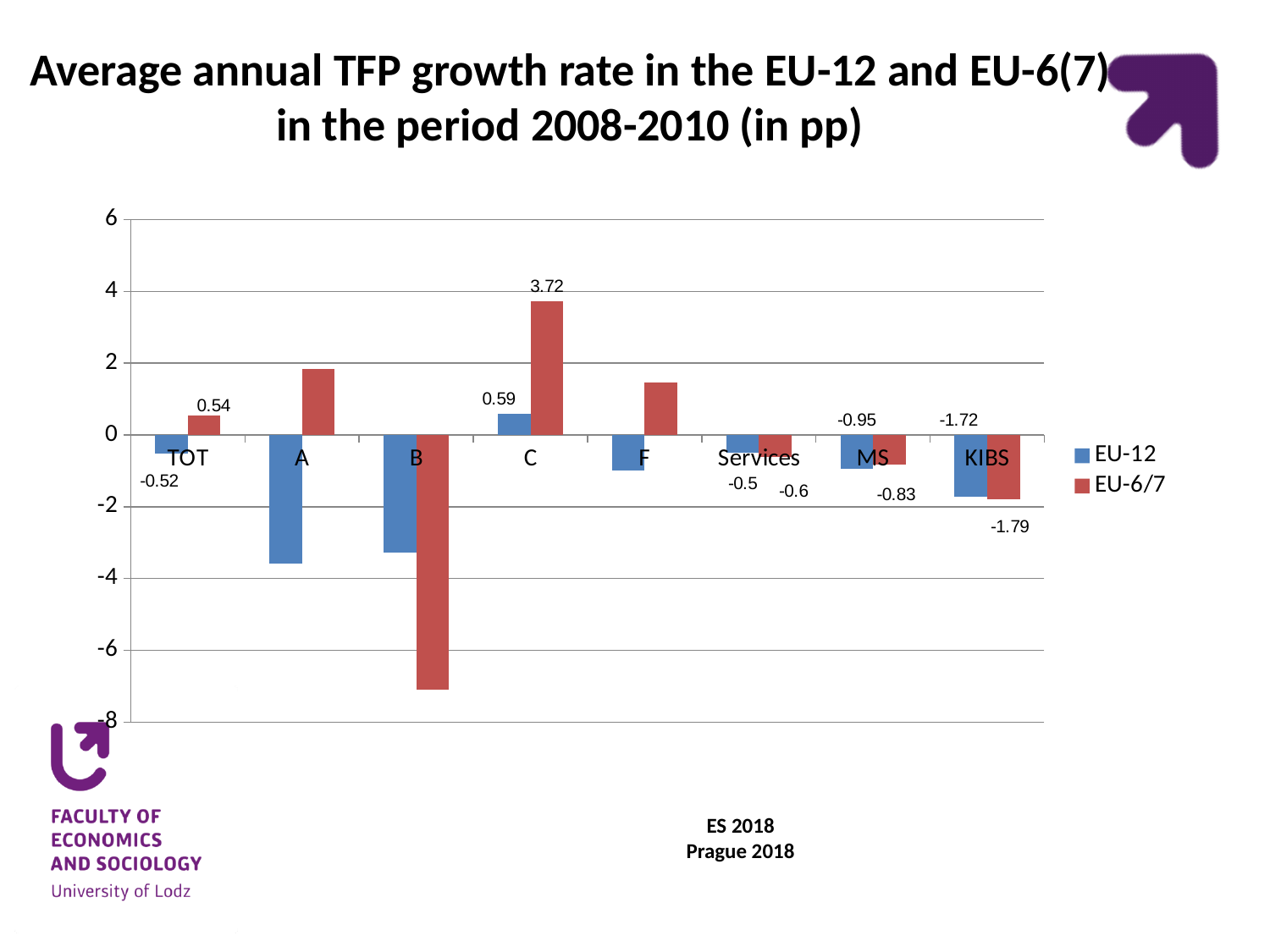
Which category has the lowest EU-6/7 value? B What is the EU-12 value for TOT? -0.52 How many series does the legend list? 2 For category C, what is the difference between the EU-6/7 value and the EU-12 value? 3.13 How many categories are shown on the x axis? 8 For MS, which series has the larger value, EU-12 or EU-6/7? EU-6/7 What kind of chart is shown on the slide? bar chart Is the EU-12 value for A greater or less than -2? less Which category has the highest EU-6/7 value? C What is the EU-6/7 value for KIBS? -1.79 Is the EU-6/7 value for B greater or less than -6? less What is the EU-6/7 value for category C? 3.72